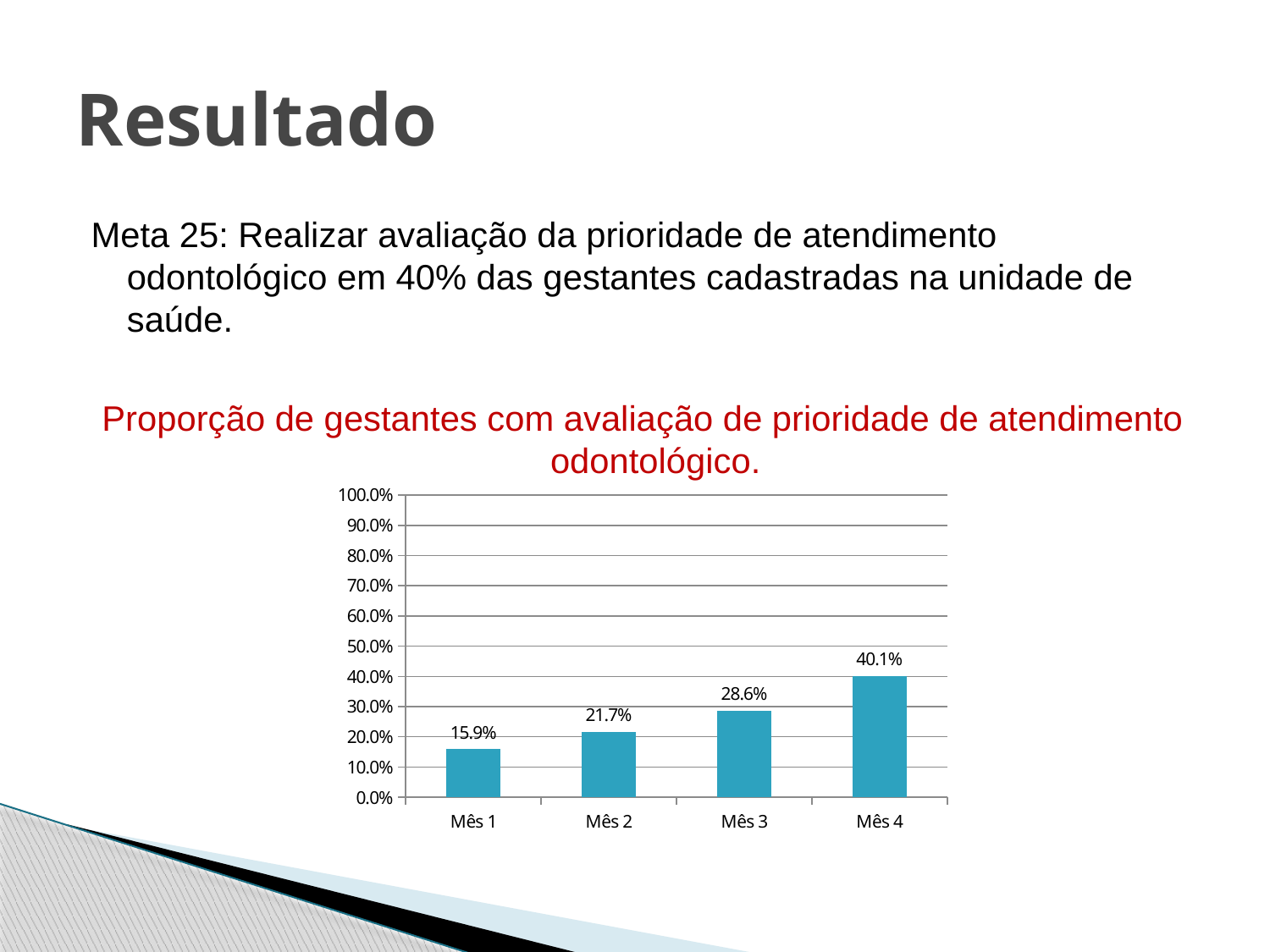
What is the value for Mês 3? 28.6% How many months are shown on the x axis? 4 Do the values rise or fall from Mês 1 to Mês 4? rise What is the difference between the values for Mês 4 and Mês 1? 24.2% Which month has the lowest value? Mês 1 What is the difference between the values for Mês 3 and Mês 2? 6.9% Is the value for Mês 4 greater or less than 30.0%? greater What is the value for Mês 1? 15.9% What is the value for Mês 4? 40.1% Which is larger, the value for Mês 2 or the value for Mês 3? Mês 3 What kind of chart is shown on the slide? bar chart Which month has the highest value? Mês 4